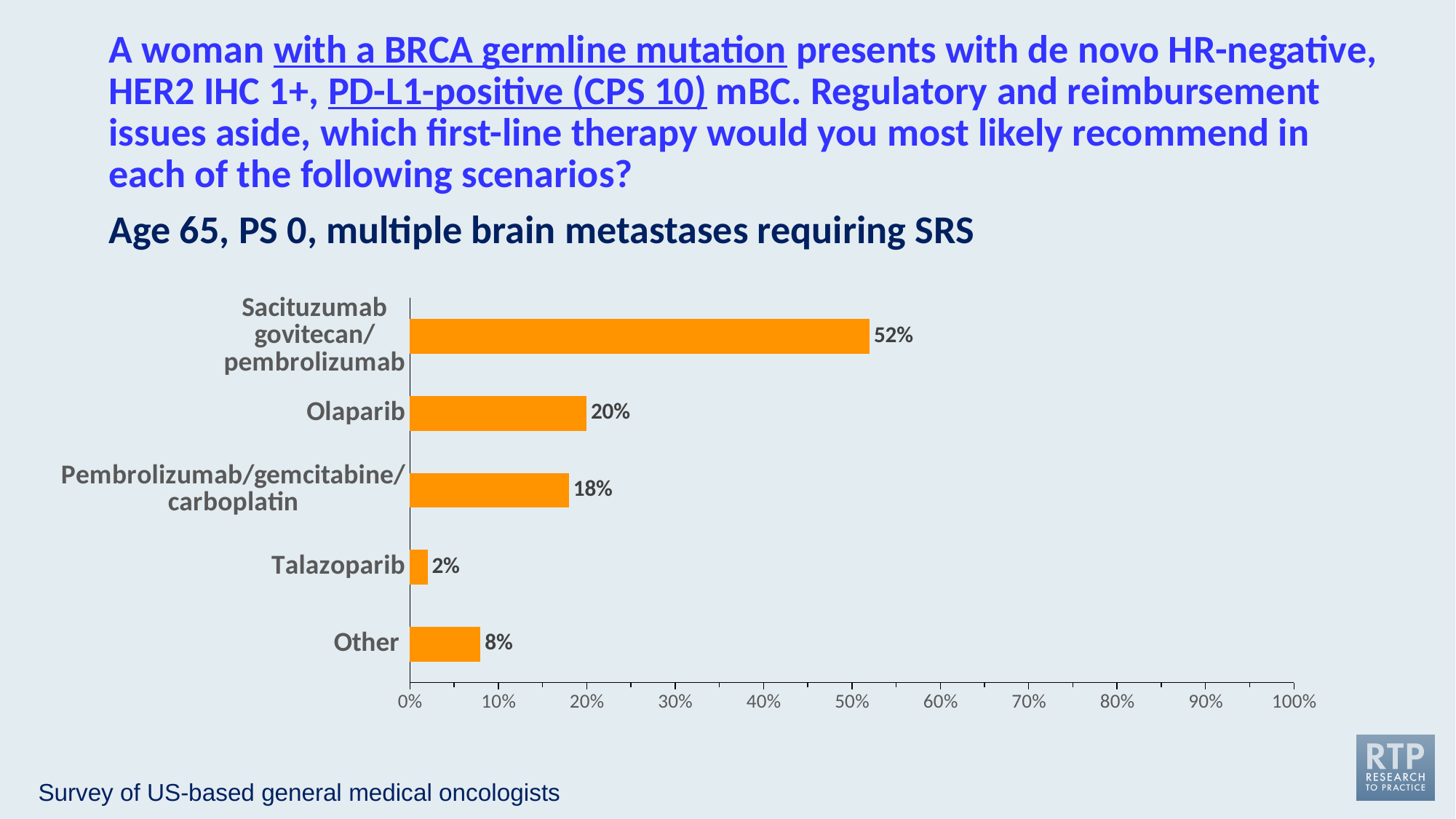
Which therapy option received the lowest percentage? Talazoparib What percentage of respondents chose Other? 8% What percentage of respondents chose Talazoparib? 2% Which therapy option received the highest percentage? Sacituzumab govitecan/pembrolizumab What percentage of respondents chose Sacituzumab govitecan/pembrolizumab? 52% How many therapy options are shown in the chart? 5 What is the maximum value shown on the x axis of the chart? 100% What percentage of respondents chose Olaparib? 20% What percentage of respondents chose Pembrolizumab/gemcitabine/carboplatin? 18% Which received a larger share of responses, Olaparib or Other? Olaparib What is the difference in percentage points between Sacituzumab govitecan/pembrolizumab and Olaparib? 32 What type of chart is shown on the slide? Bar chart